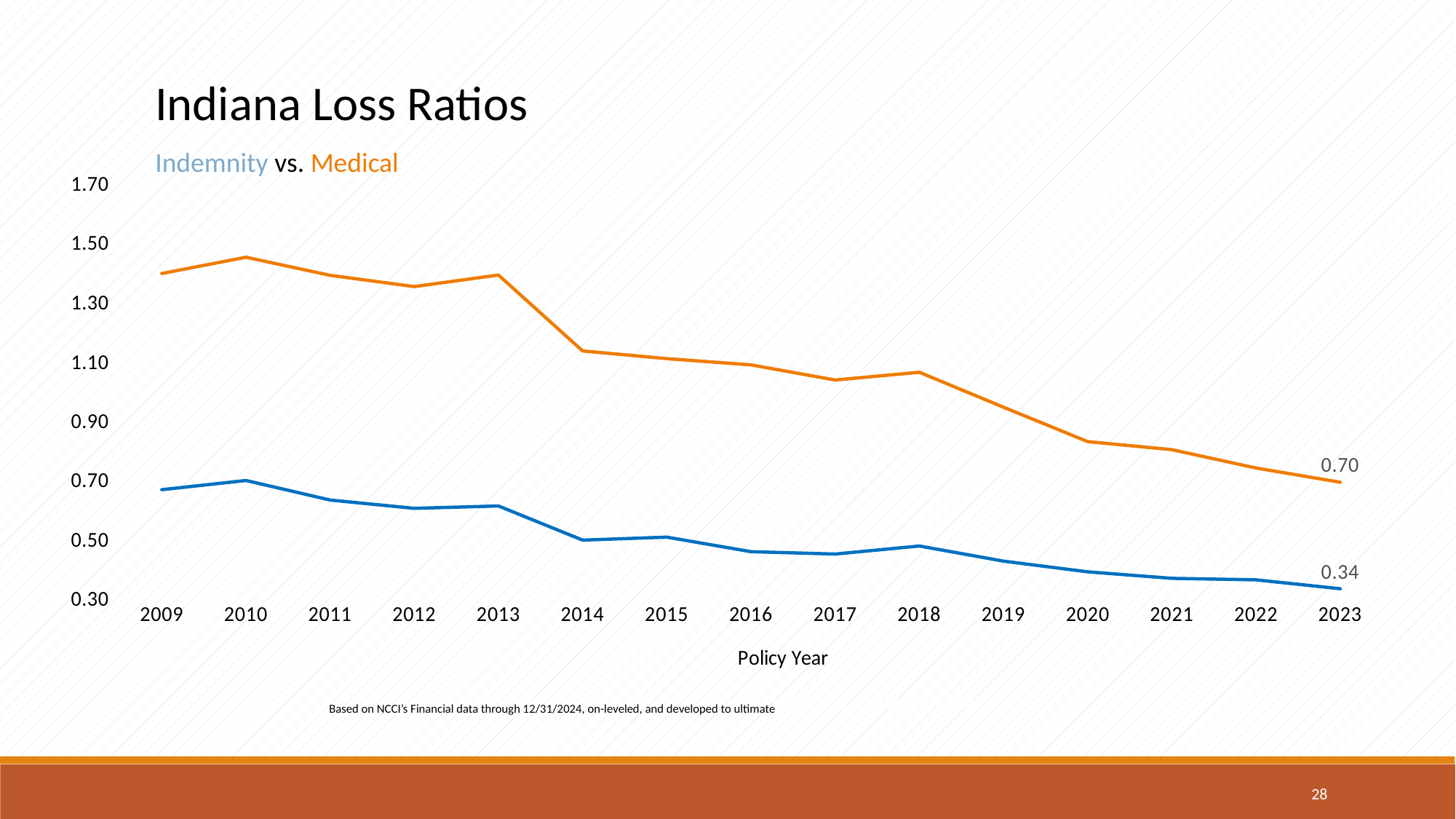
In which policy year is the Medical loss ratio highest? 2010 What is the Medical loss ratio for policy year 2023? 0.70 Does the Medical loss ratio generally rise or fall from 2009 to 2023? Fall Is the Indemnity loss ratio for 2014 greater or less than 0.70? less How many series does the chart show? 2 What is the Indemnity loss ratio for policy year 2023? 0.34 What is the difference between the Medical and Indemnity loss ratios in 2023? 0.36 What is the title of the x axis? Policy Year What kind of chart is shown on the slide? Line chart In 2023, which series has the higher loss ratio, Indemnity or Medical? Medical How many policy years are plotted on the x axis? 15 Is the Medical loss ratio for 2010 greater or less than 1.30? greater